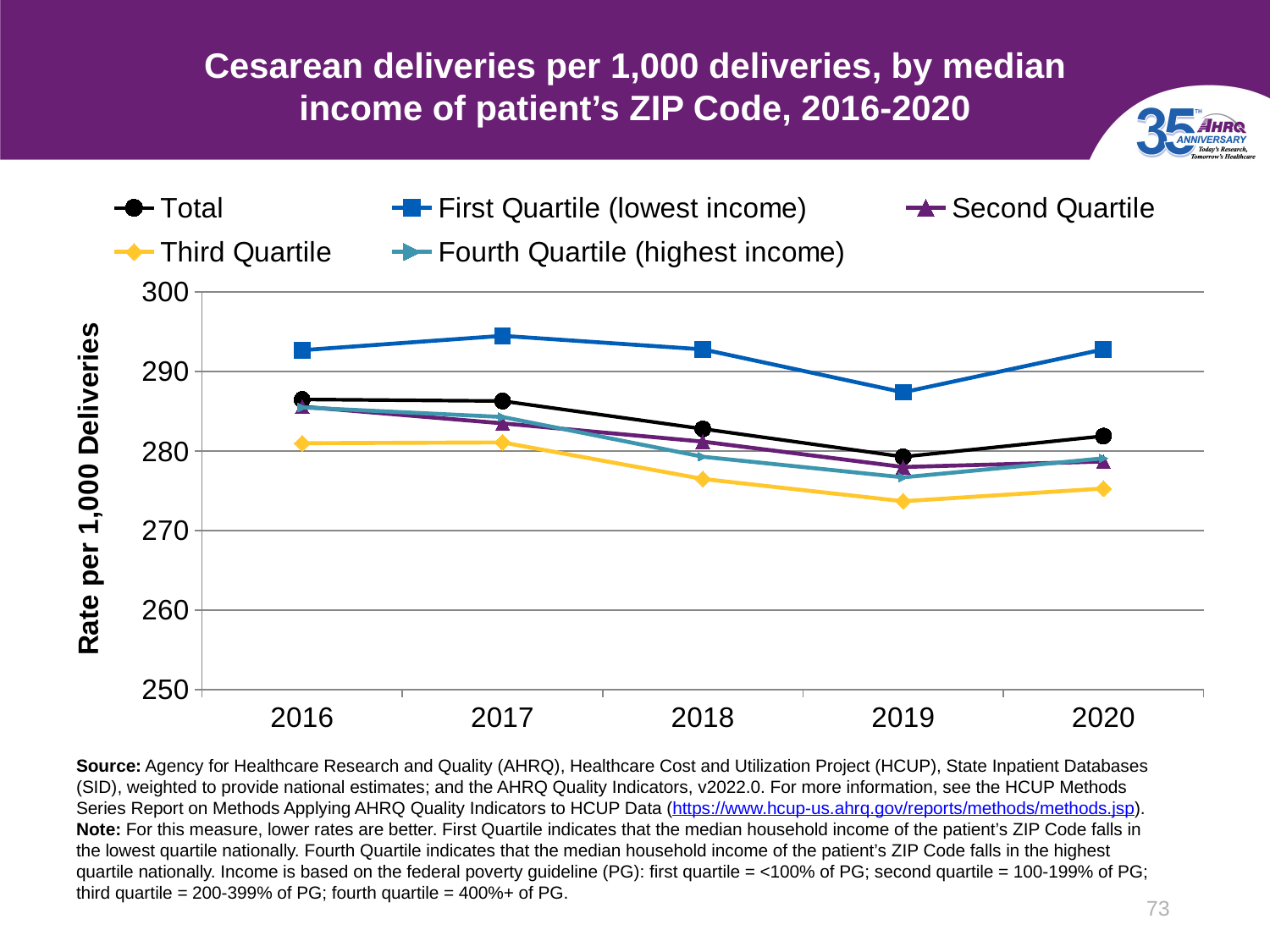
Is the value for First Quartile (lowest income) in 2017 greater or less than 290? greater What kind of chart is shown on the slide? line chart Between 2017 and 2019, does the Total rate rise or fall? fall Is the value for Third Quartile in 2019 greater or less than 280? less In which year is the Total rate lowest? 2019 How many years are plotted along the x axis? 5 In 2018, which is larger: the rate for First Quartile (lowest income) or the rate for Third Quartile? First Quartile (lowest income) Which series has the lowest rate in 2018? Third Quartile Is the value for Total in 2016 greater or less than 290? less Which series has the highest rate in 2016? First Quartile (lowest income) What is the label on the y axis? Rate per 1,000 Deliveries How many series does the legend list? 5